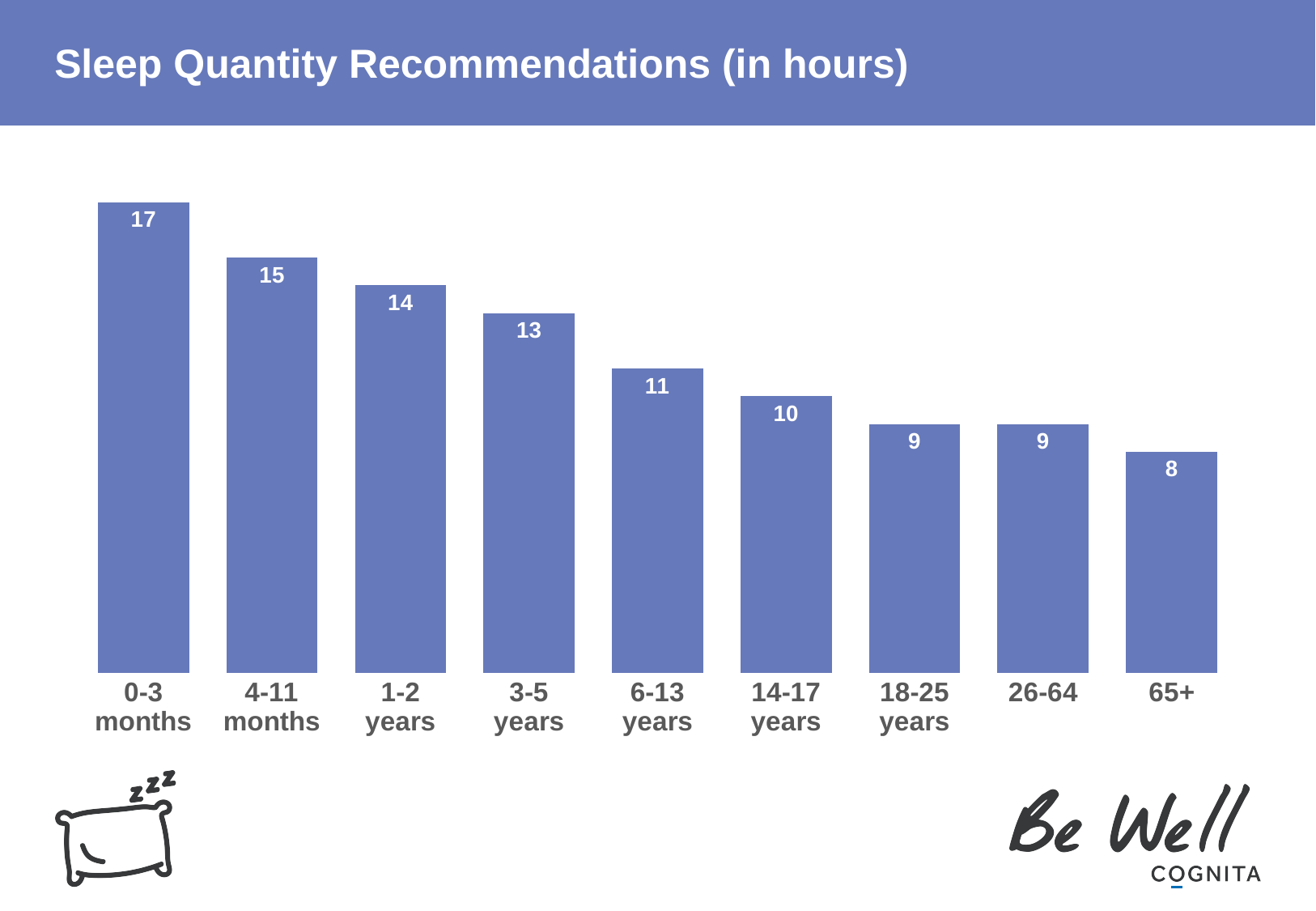
What is the title of the chart? Sleep Quantity Recommendations (in hours) Which has a higher recommended sleep quantity, 1-2 years or 18-25 years? 1-2 years What kind of chart is shown on the slide? Bar chart Which age group has the lowest recommended sleep quantity? 65+ Do the recommended sleep hours rise or fall as age increases along the x axis? Fall What is the recommended sleep quantity for 0-3 months? 17 What is the recommended sleep quantity for 6-13 years? 11 Which age group has the highest recommended sleep quantity? 0-3 months What is the difference in recommended sleep hours between 3-5 years and 65+? 5 What is the difference in recommended sleep hours between 4-11 months and 14-17 years? 5 How many age groups are shown in the chart? 9 What is the recommended sleep quantity for 65+? 8